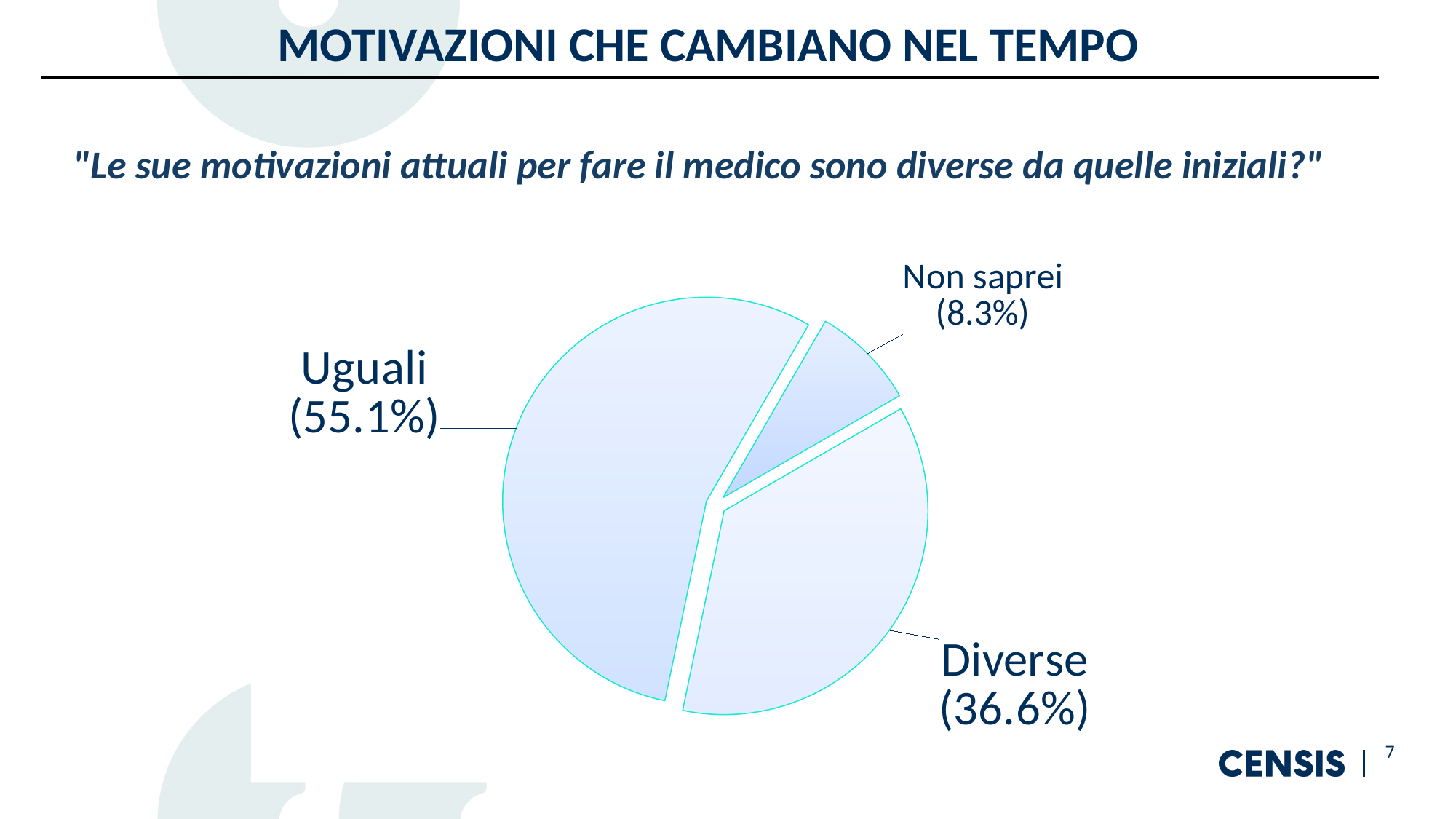
Which is larger, the share for "Diverse" or the share for "Non saprei"? Diverse What share of respondents answered "Uguali"? 55.1% What is the difference in percentage points between "Diverse" and "Non saprei"? 28.3 Is the share for "Uguali" greater or less than 50%? greater How many slices does the pie chart have? 3 What is the title of the slide containing the pie chart? MOTIVAZIONI CHE CAMBIANO NEL TEMPO What kind of chart is shown on the slide? pie chart What share of respondents answered "Diverse"? 36.6% Which slice of the pie is the largest? Uguali Which slice of the pie is the smallest? Non saprei What share of respondents answered "Non saprei"? 8.3% What is the difference in percentage points between "Uguali" and "Diverse"? 18.5